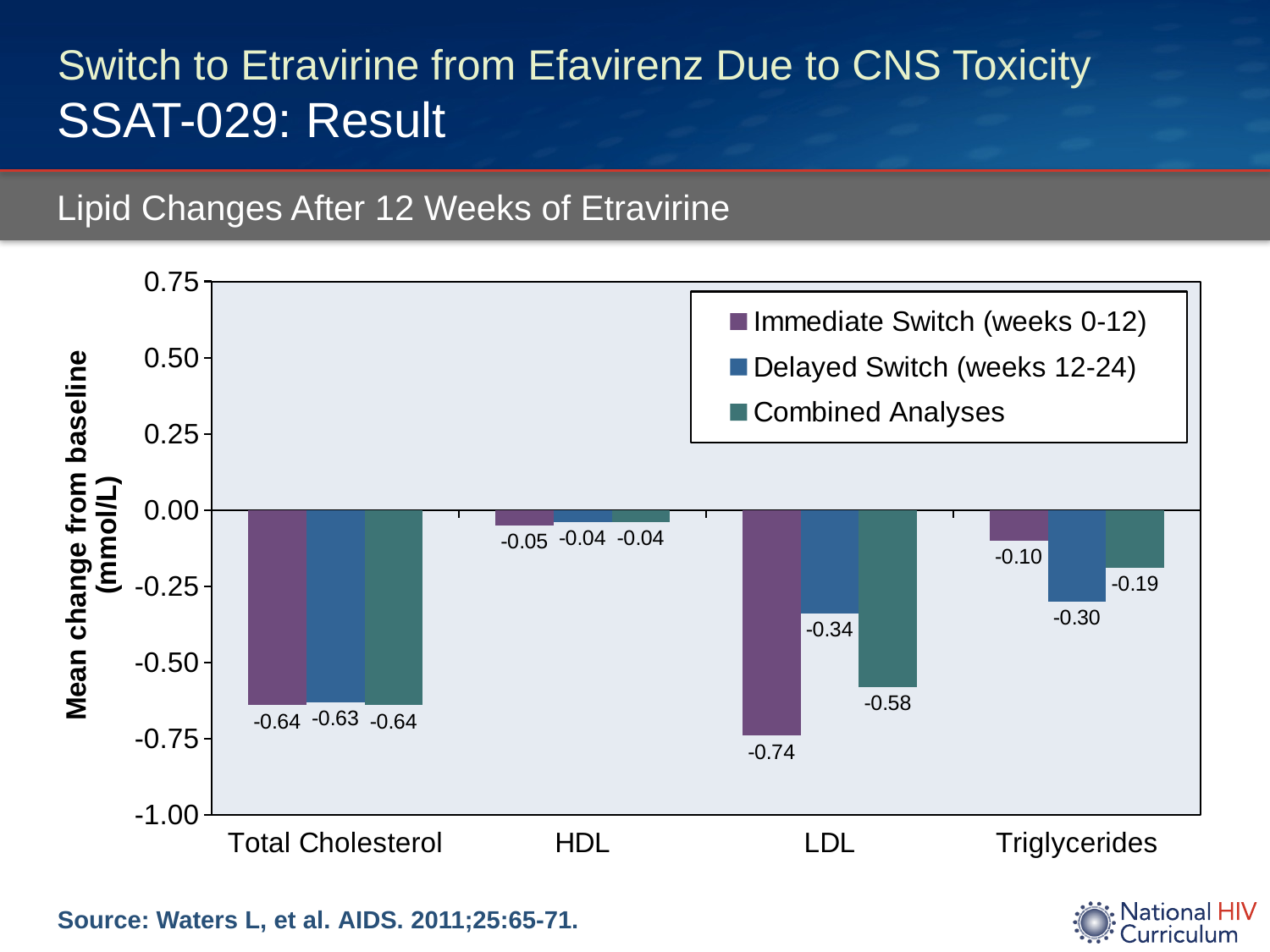
What kind of chart is shown on the slide? Bar chart What is the difference between the Immediate Switch and Delayed Switch values for LDL? 0.40 Which lipid category has the largest decrease from baseline in the Immediate Switch (weeks 0-12) group? LDL How many series does the legend list? 3 Is the Combined Analyses value for LDL greater or less than -0.50? less How many lipid categories are shown on the x axis? 4 What is the mean change from baseline in Triglycerides for the Delayed Switch (weeks 12-24) group? -0.30 What is the mean change from baseline in LDL for the Immediate Switch (weeks 0-12) group? -0.74 What is the Combined Analyses value for Total Cholesterol? -0.64 For Triglycerides, which group shows a larger decrease from baseline: Delayed Switch (weeks 12-24) or Combined Analyses? Delayed Switch (weeks 12-24) Which lipid category has the smallest change from baseline in the Combined Analyses series? HDL What is the label of the y axis? Mean change from baseline (mmol/L)